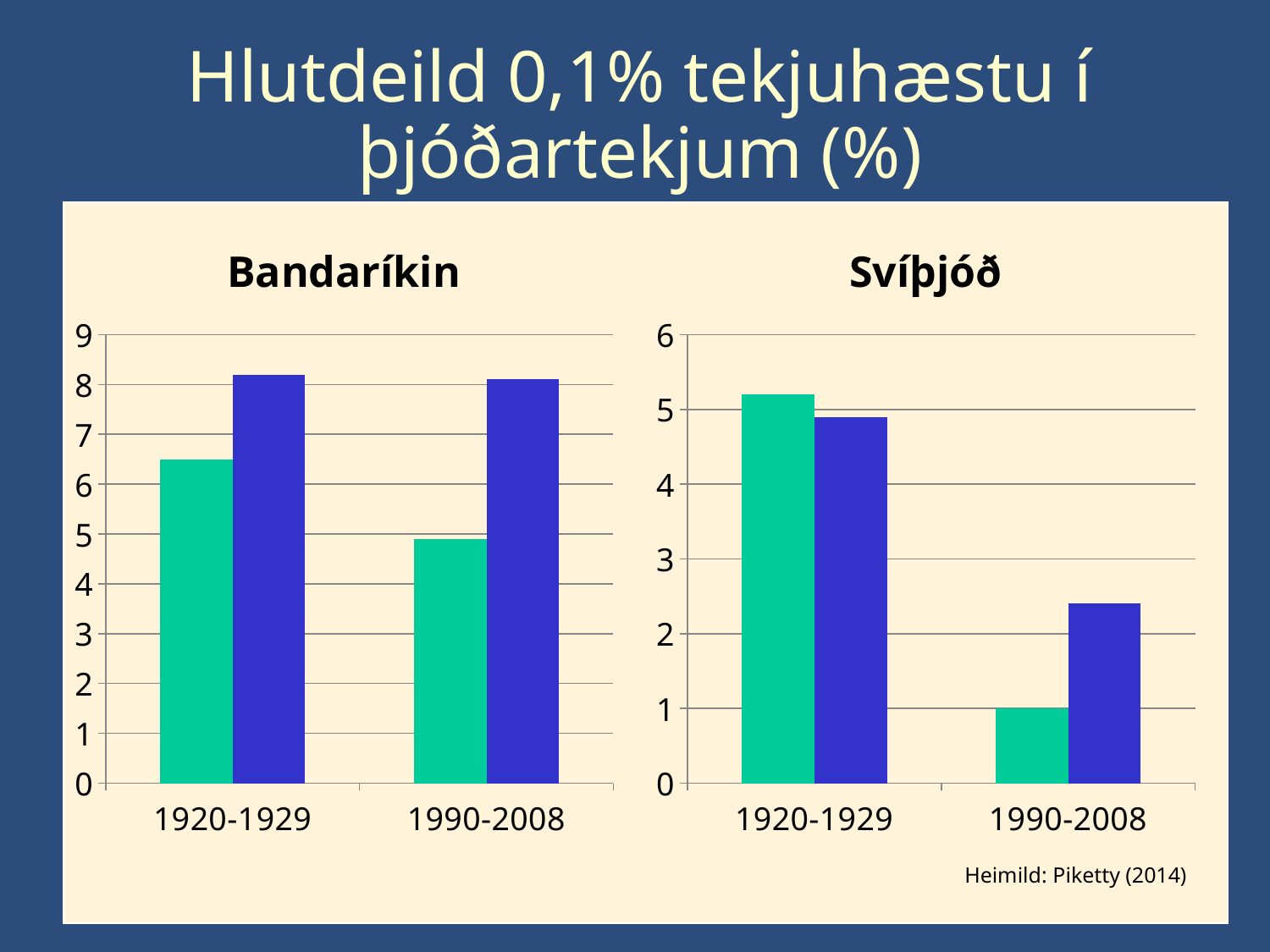
In the Svíþjóð chart, is the green bar for 1990-2008 greater or less than 2? less In the Svíþjóð chart, is the blue bar for 1990-2008 greater or less than 2? greater In the Svíþjóð chart, which bar is the lowest? the green bar for 1990-2008 In the Bandaríkin chart, for 1920-1929, which bar is taller, the green one or the blue one? the blue one What kind of chart is the Bandaríkin chart? bar chart How many time-period categories are shown on the x axis of the Svíþjóð chart? 2 What source is cited at the bottom of the slide? Heimild: Piketty (2014) In the Svíþjóð chart, is the green bar for 1920-1929 greater or less than 4? greater In the Svíþjóð chart, do the green bars rise or fall from 1920-1929 to 1990-2008? fall